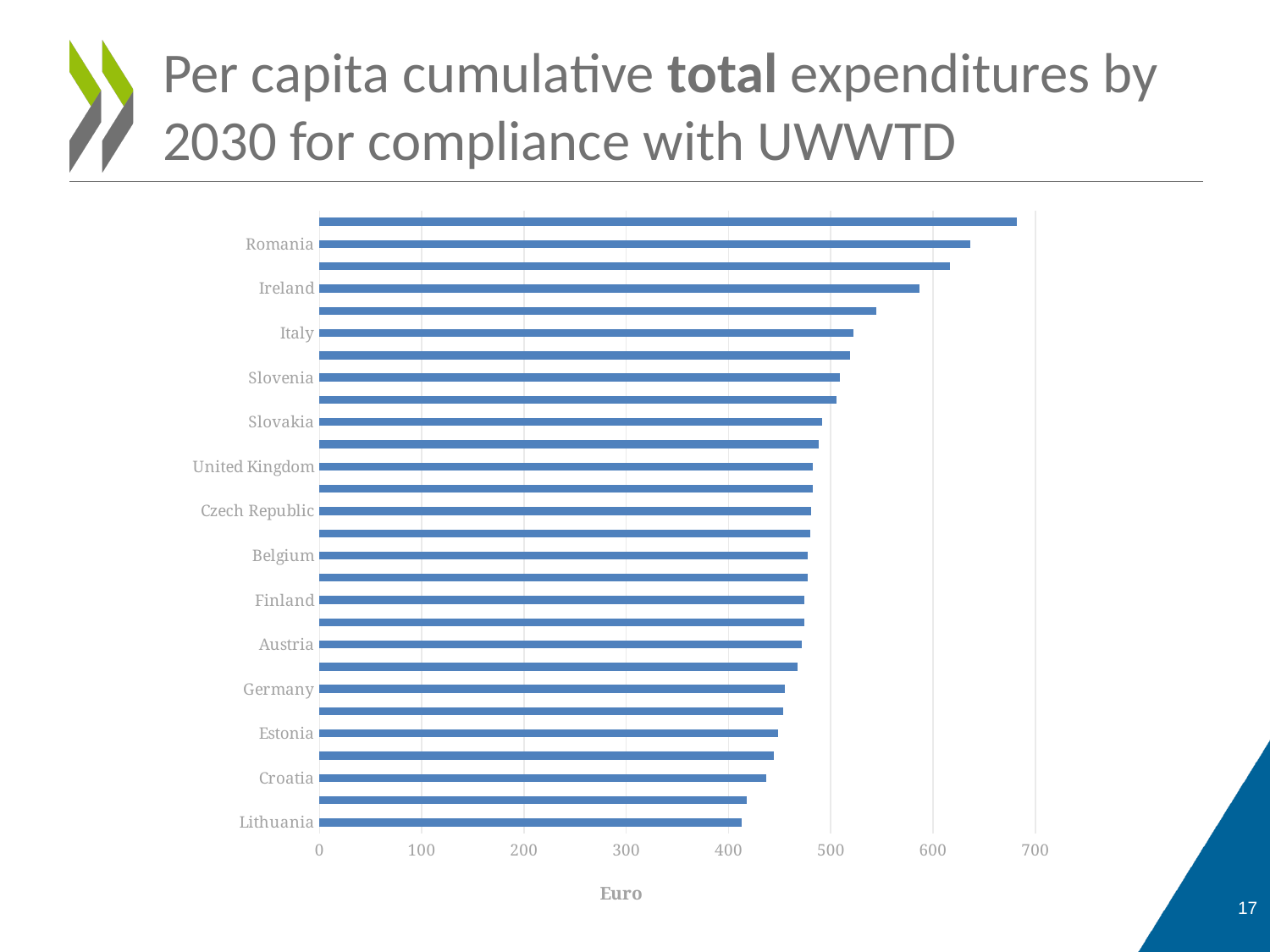
What kind of chart is shown on the slide? bar chart Is the value for Italy greater or less than 500? greater Is the value for Germany greater or less than 500? less Is the value for United Kingdom greater or less than 500? less What is the title of the horizontal axis? Euro Of the countries labeled on the vertical axis, which has the lowest value? Lithuania Which has the larger value, Romania or Lithuania? Romania Do the bar values increase or decrease going from the top of the chart to the bottom? decrease